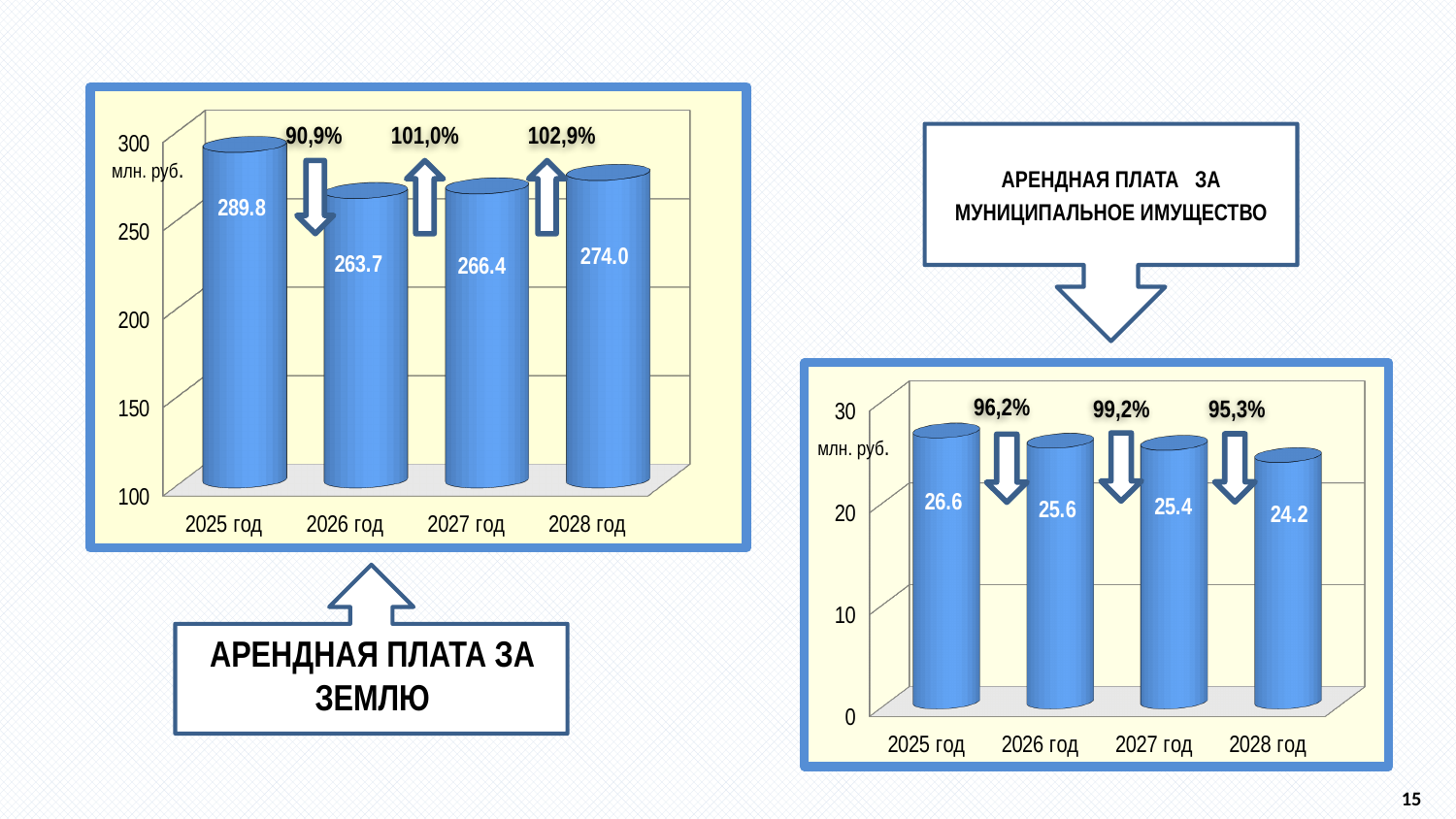
What kind of chart is the 'АРЕНДНАЯ ПЛАТА ЗА ЗЕМЛЮ' chart? bar chart In the 'АРЕНДНАЯ ПЛАТА ЗА ЗЕМЛЮ' chart, what percentage label is shown between 2027 год and 2028 год? 102,9% In the 'АРЕНДНАЯ ПЛАТА ЗА ЗЕМЛЮ' chart, which year has the lowest value? 2026 год In the 'АРЕНДНАЯ ПЛАТА ЗА МУНИЦИПАЛЬНОЕ ИМУЩЕСТВО' chart, do the values rise or fall from 2025 год to 2028 год? fall In the 'АРЕНДНАЯ ПЛАТА ЗА ЗЕМЛЮ' chart, what is the value for 2027 год? 266.4 In the 'АРЕНДНАЯ ПЛАТА ЗА МУНИЦИПАЛЬНОЕ ИМУЩЕСТВО' chart, what is the value for 2028 год? 24.2 In the 'АРЕНДНАЯ ПЛАТА ЗА ЗЕМЛЮ' chart, what is the difference between the values for 2025 год and 2026 год? 26.1 How many years are shown on the x axis of the 'АРЕНДНАЯ ПЛАТА ЗА МУНИЦИПАЛЬНОЕ ИМУЩЕСТВО' chart? 4 In the 'АРЕНДНАЯ ПЛАТА ЗА МУНИЦИПАЛЬНОЕ ИМУЩЕСТВО' chart, what is the difference between the values for 2025 год and 2028 год? 2.4 In the 'АРЕНДНАЯ ПЛАТА ЗА ЗЕМЛЮ' chart, which year has the highest value? 2025 год In the 'АРЕНДНАЯ ПЛАТА ЗА ЗЕМЛЮ' chart, what is the value for 2025 год? 289.8 In the 'АРЕНДНАЯ ПЛАТА ЗА МУНИЦИПАЛЬНОЕ ИМУЩЕСТВО' chart, what is the value for 2026 год? 25.6